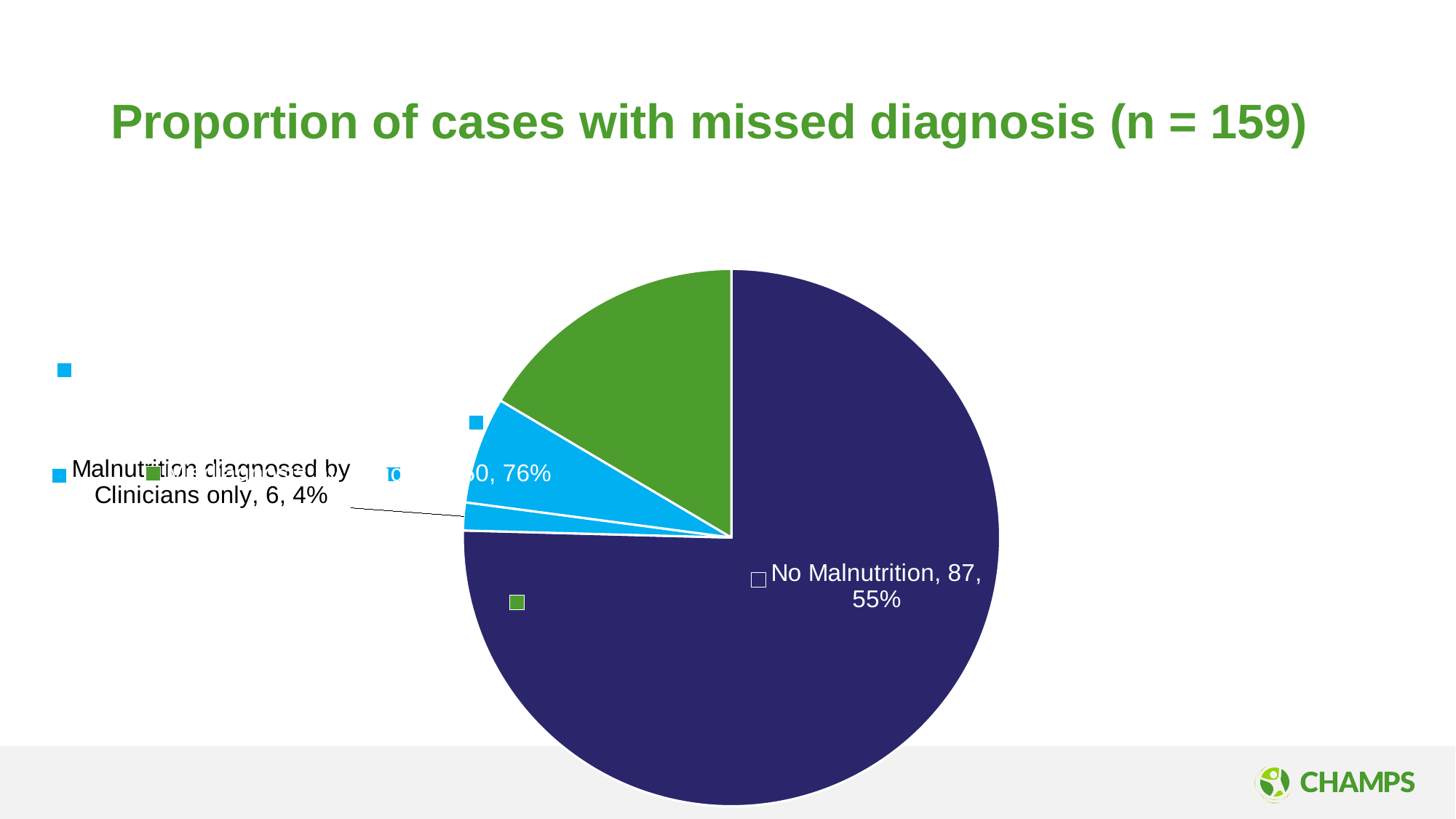
Which slice of the pie is the largest? No Malnutrition How many cases are in the No Malnutrition slice? 87 What kind of chart is shown on the slide? Pie chart Is the share of the No Malnutrition slice greater or less than 50%? greater How many more cases are in the No Malnutrition slice than in the Malnutrition diagnosed by Clinicians only slice? 81 Which has more cases, No Malnutrition or Malnutrition diagnosed by Clinicians only? No Malnutrition What colour is the No Malnutrition slice? Dark blue What percentage of the pie is the No Malnutrition slice? 55% What share of the pie is the Malnutrition diagnosed by Clinicians only slice? 4% Which slice of the pie is the smallest? Malnutrition diagnosed by Clinicians only How many cases are in the Malnutrition diagnosed by Clinicians only slice? 6 What is the title of the chart? Proportion of cases with missed diagnosis (n = 159)